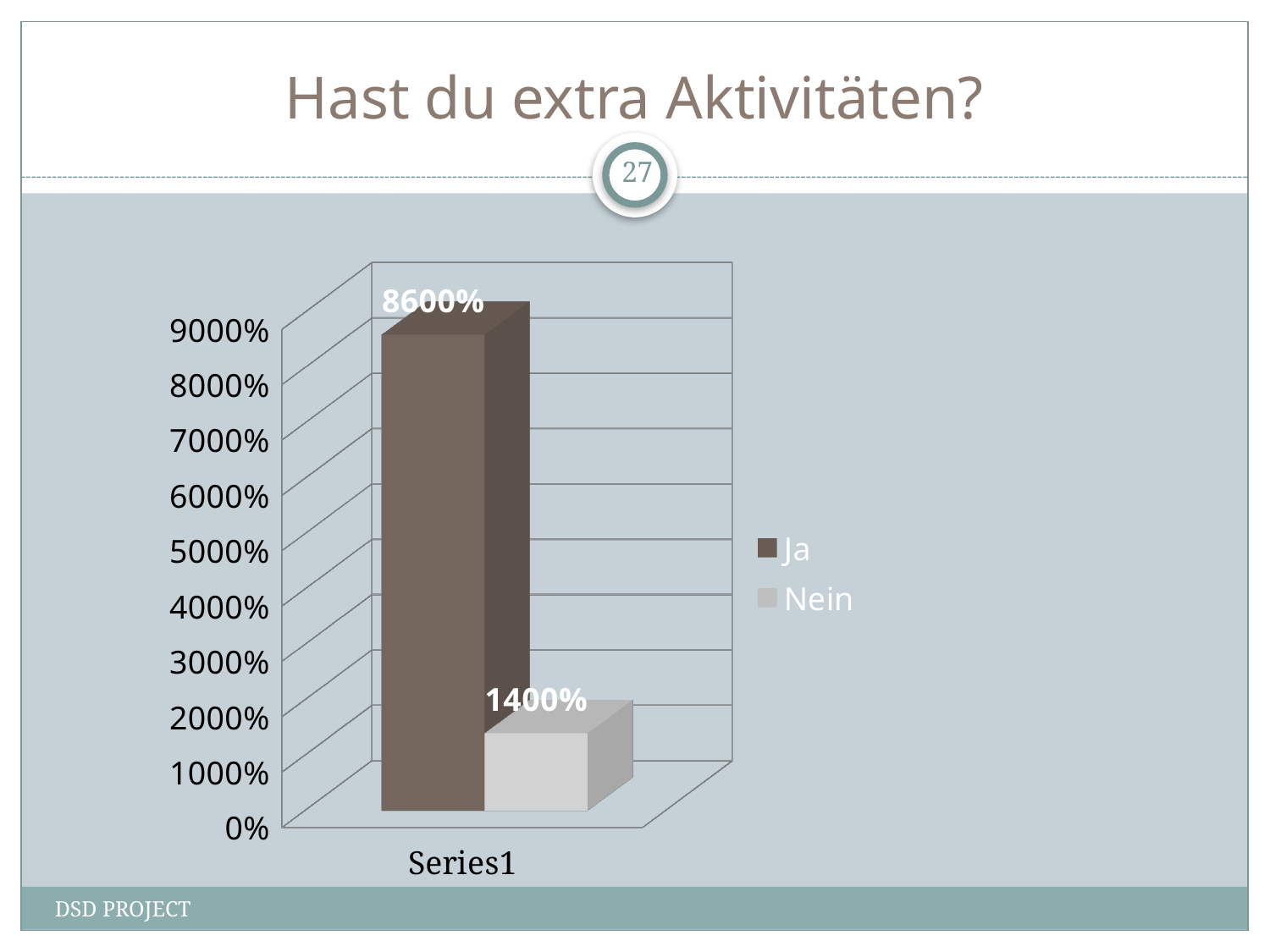
Is the value for Ja greater or less than 8000%? greater Which is larger, the value for Ja or the value for Nein? Ja What is the label on the x axis under the bars? Series1 Which series has the lowest value? Nein How many series does the legend list? 2 Is the value for Nein greater or less than 2000%? less What kind of chart is shown on the slide? bar chart What is the difference between the values for Ja and Nein? 7200% Which series has the highest value? Ja What is the title of the slide? Hast du extra Aktivitäten? What is the value for Nein? 1400% What is the value for Ja? 8600%